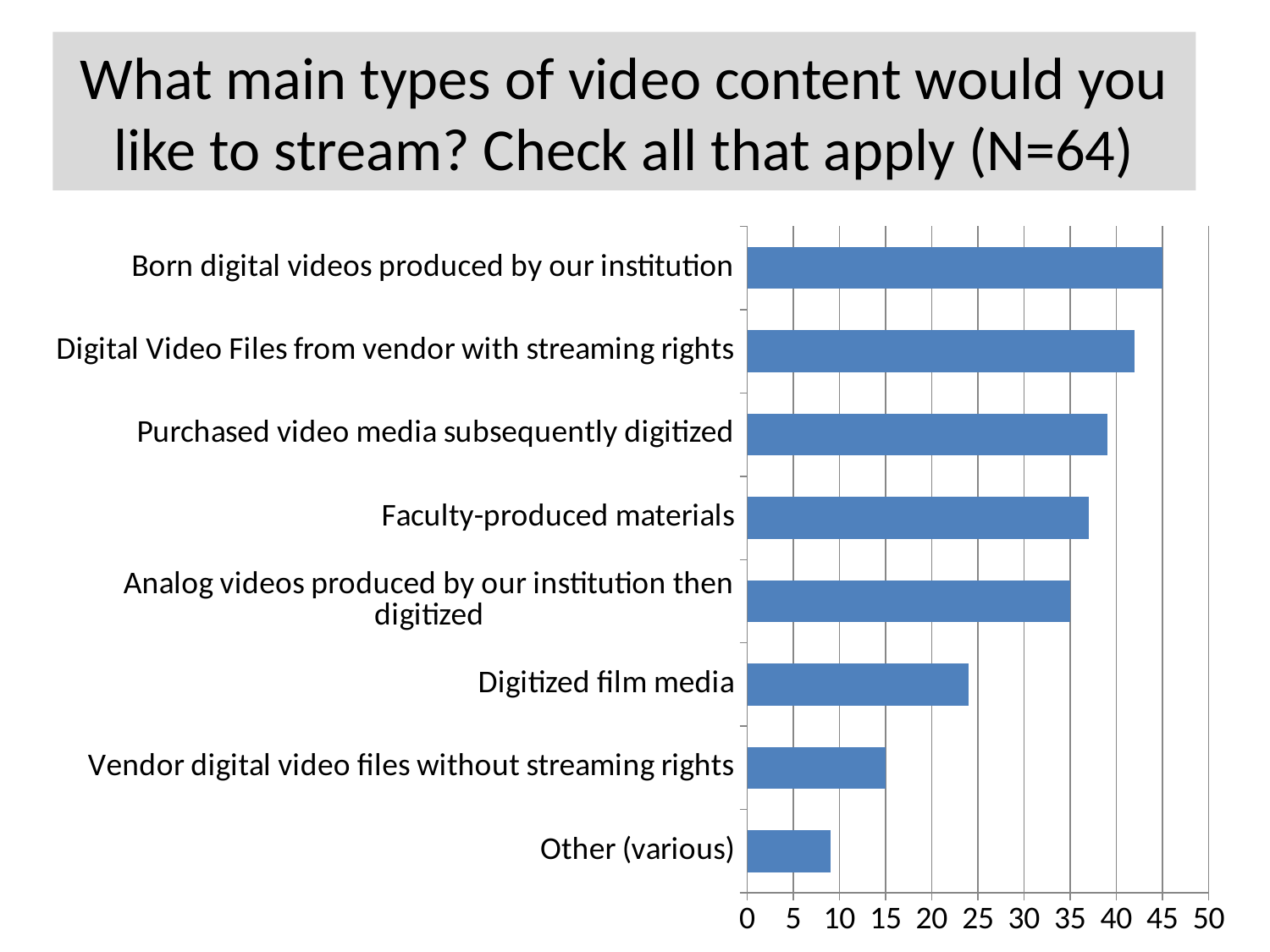
What is the value for Vendor digital video files without streaming rights? 15 Which category has the lowest value? Other (various) Which is larger: the value for Vendor digital video files without streaming rights or the value for Other (various)? Vendor digital video files without streaming rights Is the value for Digitized film media greater or less than 20? greater How many categories are plotted in the chart? 8 What is the title of the chart on the slide? What main types of video content would you like to stream? Check all that apply (N=64) Which category has the highest value? Born digital videos produced by our institution What kind of chart is shown on the slide? bar chart Is the value for Digital Video Files from vendor with streaming rights greater or less than 40? greater Which is larger: the value for Faculty-produced materials or the value for Digitized film media? Faculty-produced materials